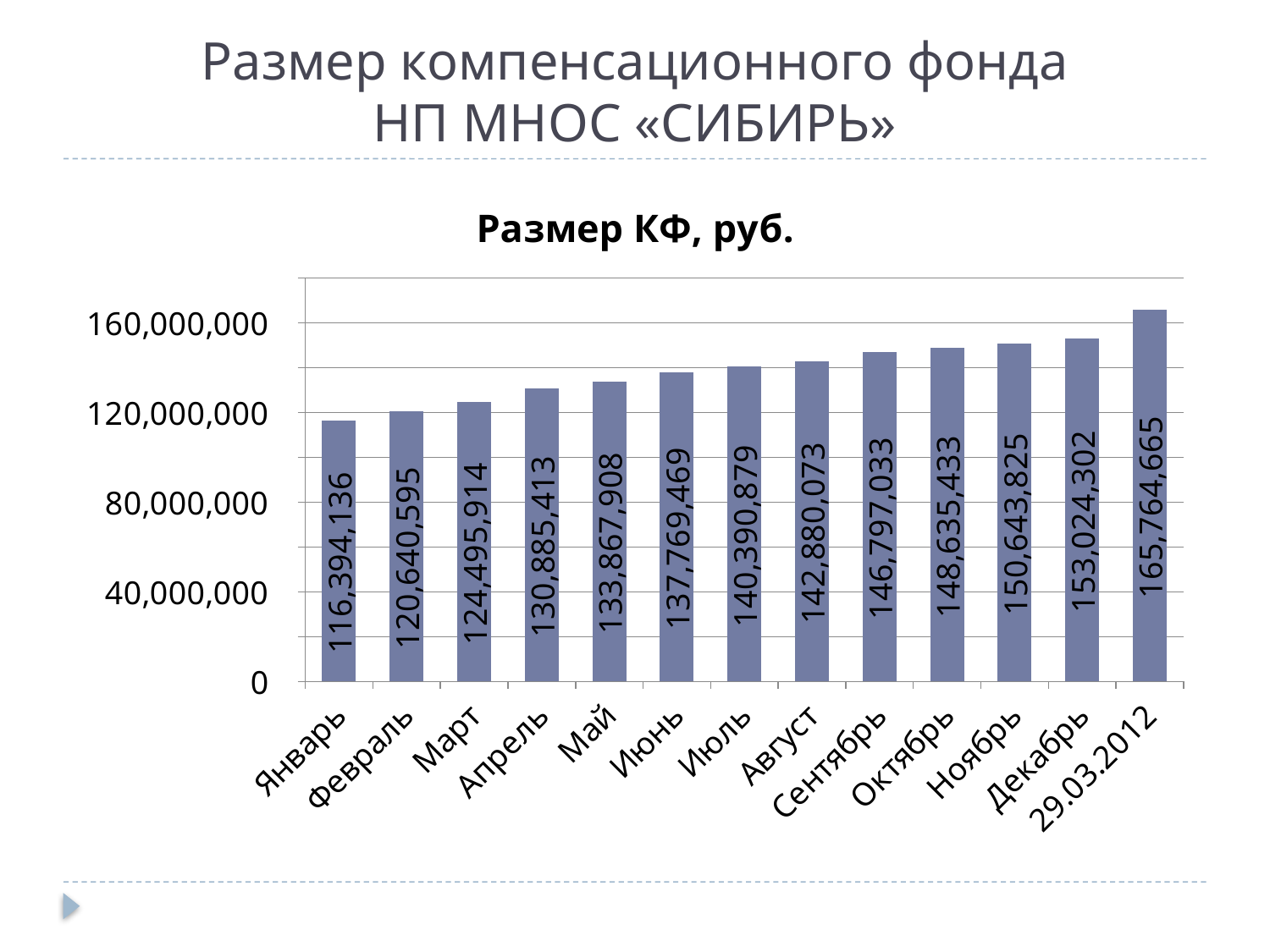
How many categories are shown on the x axis? 13 Which category has the lowest value? Январь What is the value for Март? 124,495,914 Which is larger, the value for Июнь or the value for Апрель? Июнь Is the value for Июль greater or less than 120,000,000? greater What is the difference between the values for Декабрь and Январь? 36,630,166 Do the values rise or fall from Январь to 29.03.2012? rise What is the value for 29.03.2012? 165,764,665 What kind of chart is this? bar chart Which category has the highest value? 29.03.2012 What is the value for Сентябрь? 146,797,033 What is the difference between the values for 29.03.2012 and Декабрь? 12,740,363